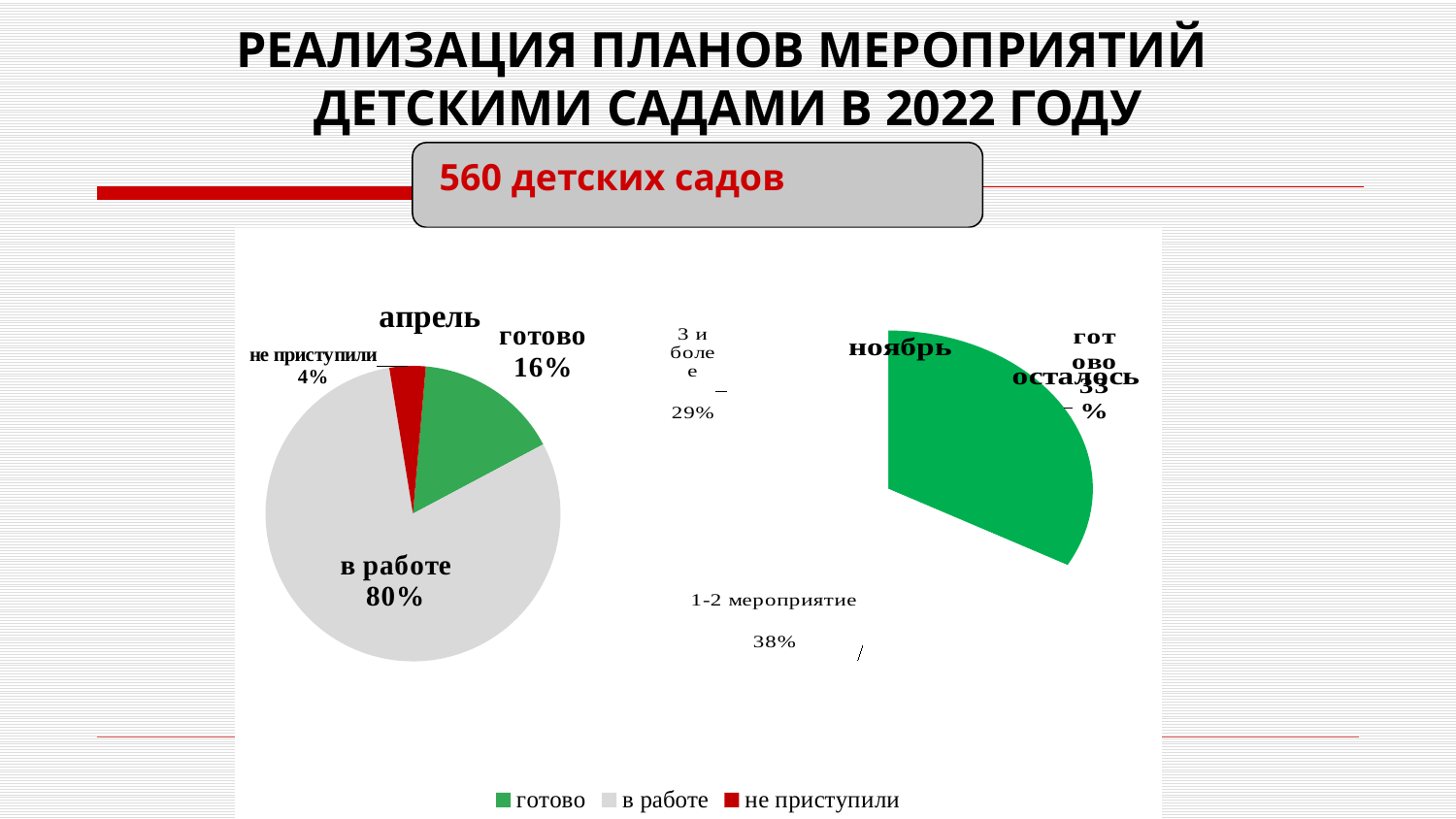
On the апрель chart, what colour is the не приступили slice? red On the апрель chart, what share is labelled в работе? 80% On the апрель chart, what is the difference between the в работе share and the готово share? 64 percentage points What type of chart is the апрель chart? pie chart On the апрель chart, what share is labelled готово? 16% How many slices does the апрель pie chart have? 3 On the ноябрь chart, what share is labelled 1-2 мероприятие? 38% On the апрель chart, what share is labelled не приступили? 4% On the апрель chart, which category has the smallest share? не приступили On the апрель chart, which category has the largest share? в работе How many entries does the legend at the bottom of the slide list? 3 On the апрель chart, which is larger: готово or не приступили? готово